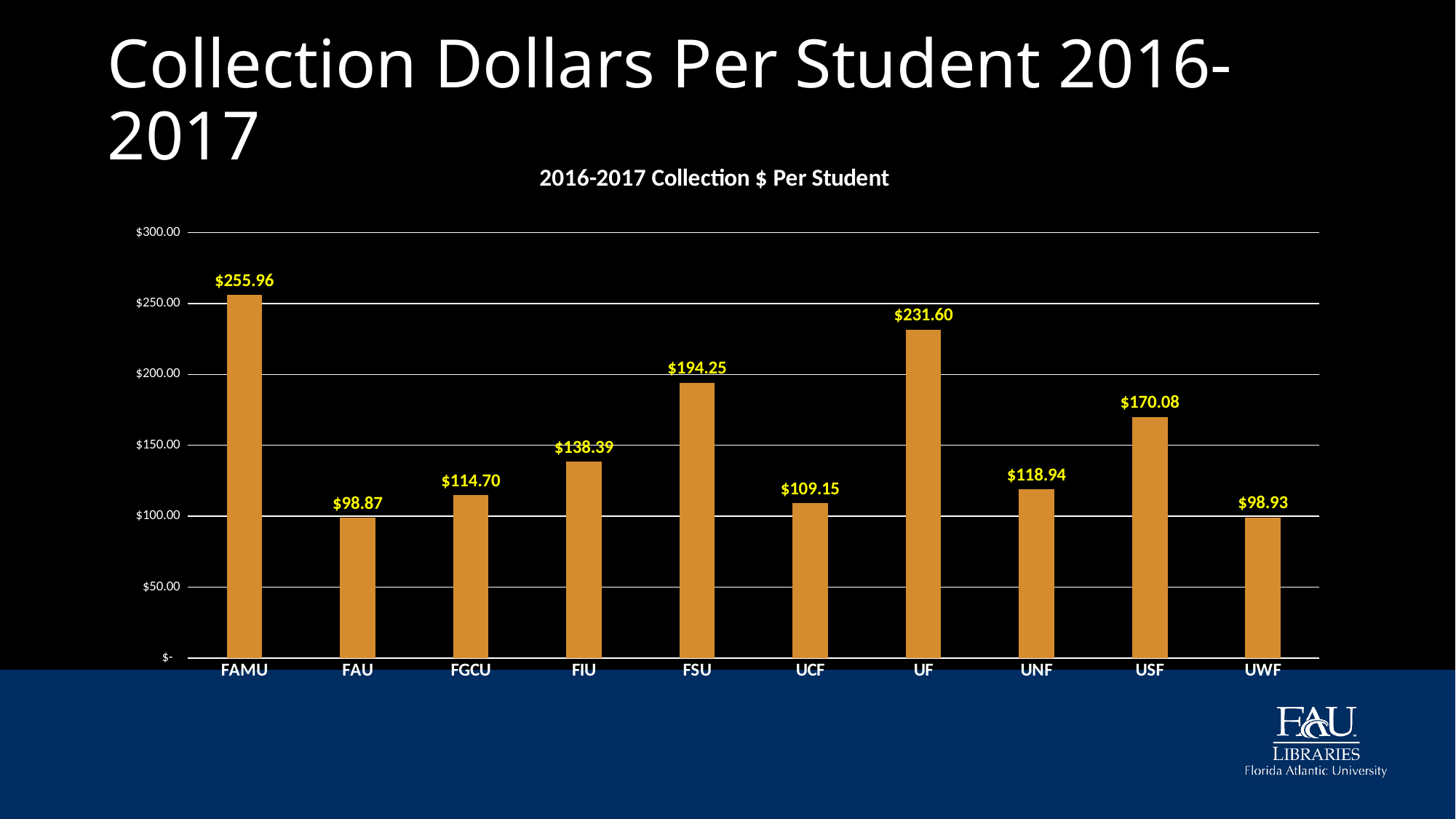
What is the difference between the values for FAMU and UF? $24.36 What is the collection dollars per student value for UF? $231.60 Which has a larger value, FSU or USF? FSU Which university has the lowest collection dollars per student? FAU How many universities are shown on the chart? 10 What is the difference between the values for USF and FIU? $31.69 What is the collection dollars per student value for FAMU? $255.96 What kind of chart is shown on the slide? bar chart Is the value for UNF greater or less than $100.00? greater What is the title of the chart? 2016-2017 Collection $ Per Student What is the collection dollars per student value for UCF? $109.15 Which university has the highest collection dollars per student? FAMU